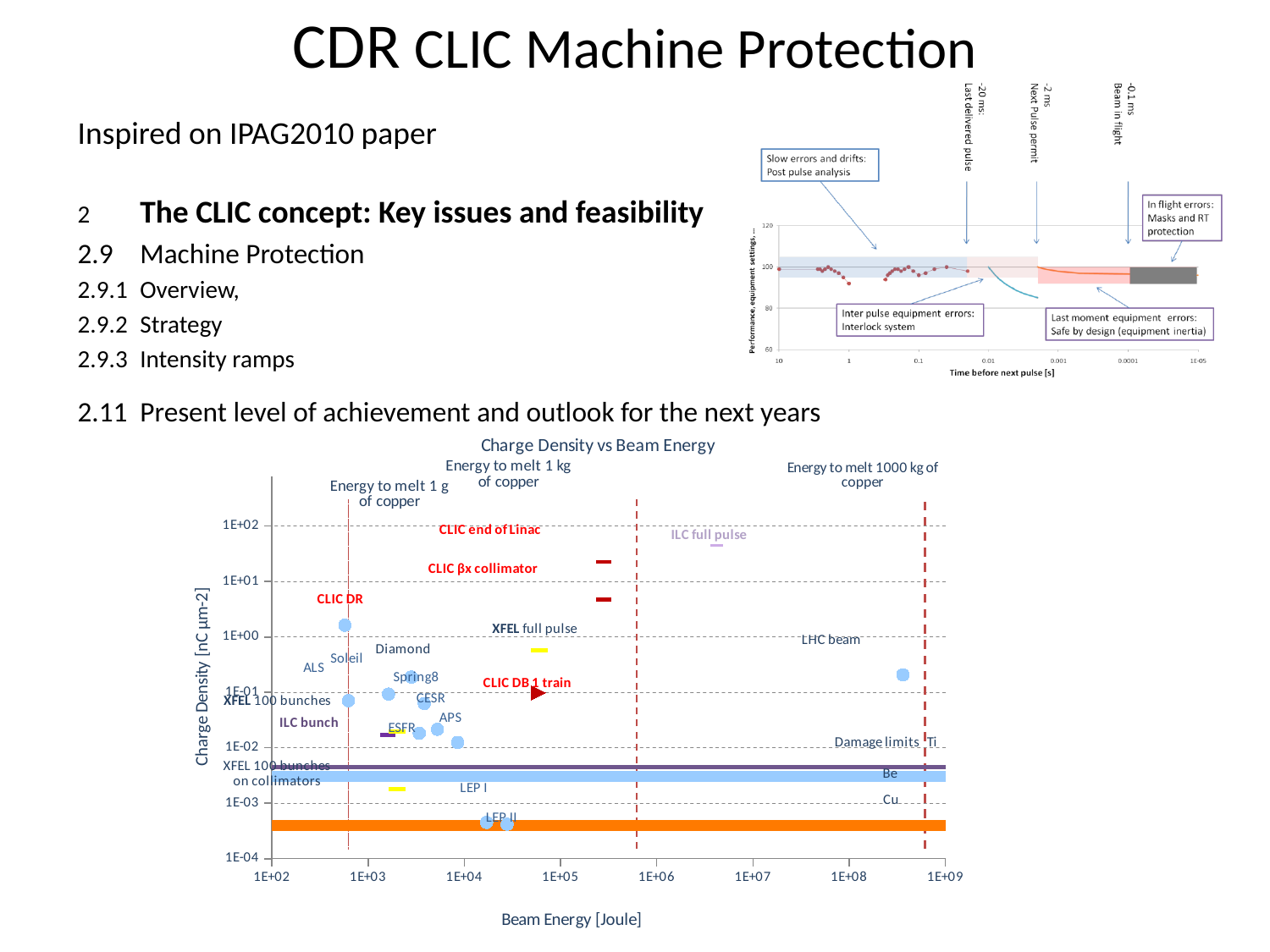
In the 'Charge Density vs Beam Energy' chart, is the charge density for CLIC DR greater or less than 1E+00? greater In the 'Charge Density vs Beam Energy' chart, is the charge density for LEP II greater or less than 1E-03? less In the 'Charge Density vs Beam Energy' chart, is the beam energy for ILC full pulse greater or less than 1E+06? greater What is the x-axis label of the small chart at the top right of the slide? Time before next pulse [s] In the 'Charge Density vs Beam Energy' chart, which has the higher beam energy, LHC beam or CLIC DR? LHC beam What kind of chart is the 'Charge Density vs Beam Energy' chart? scatter chart In the 'Charge Density vs Beam Energy' chart, which labelled point has the highest beam energy? LHC beam In the 'Charge Density vs Beam Energy' chart, which has the higher charge density, CLIC DR or LEP I? CLIC DR What is the x-axis label of the 'Charge Density vs Beam Energy' chart? Beam Energy [Joule]